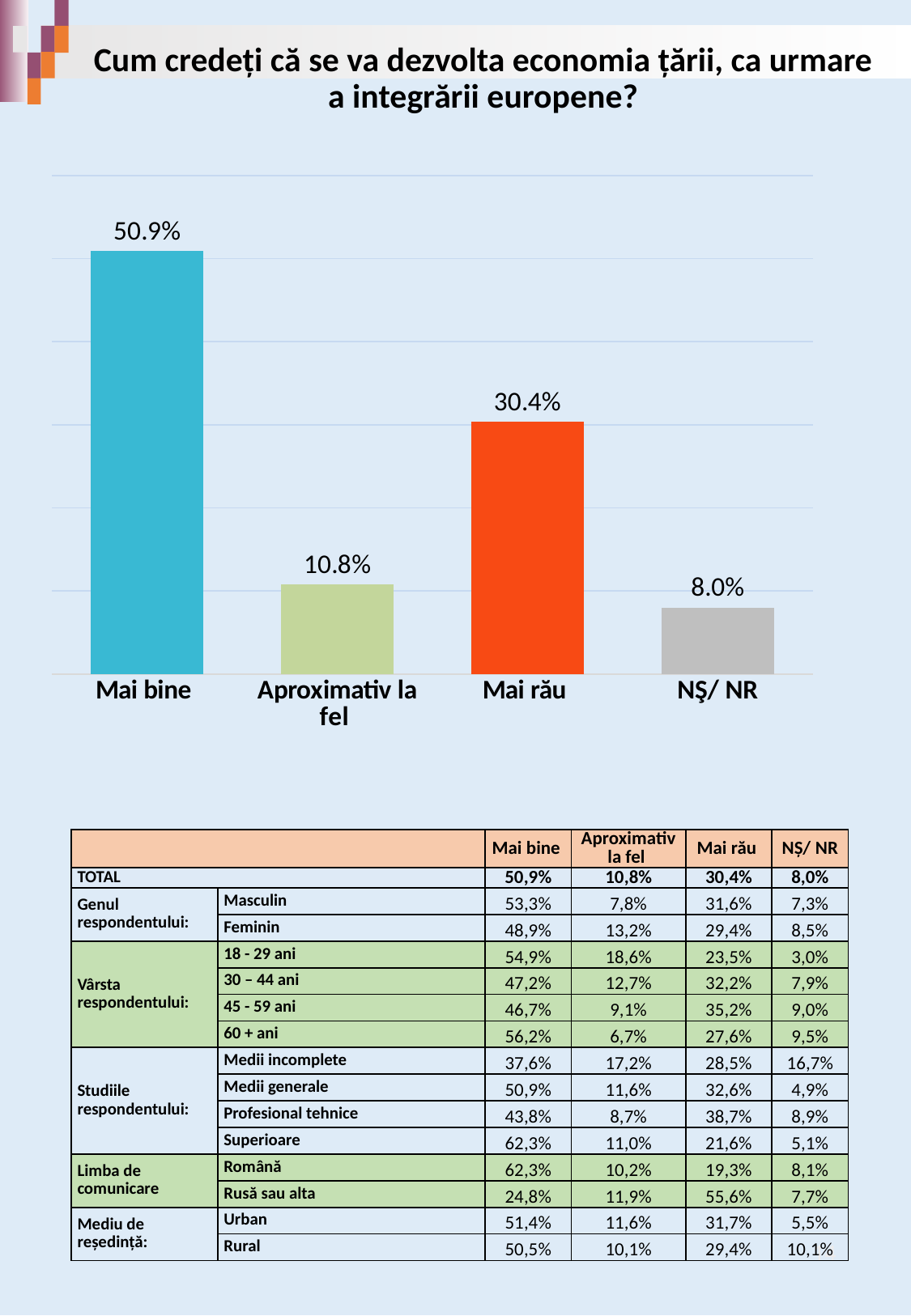
What is the difference between the values for "Mai bine" and "Mai rău" in the bar chart? 20.5% Which is larger in the bar chart, the value for "Mai rău" or the value for "Aproximativ la fel"? Mai rău Which category has the highest value in the bar chart? Mai bine How many categories are shown in the bar chart? 4 What kind of chart is shown on the slide? Bar chart What is the difference between the values for "Aproximativ la fel" and "NȘ/ NR" in the bar chart? 2.8% What is the value shown for "Aproximativ la fel" in the bar chart? 10.8% What is the value shown for "Mai rău" in the bar chart? 30.4% What colour is the bar for "Mai rău" in the bar chart? Orange-red Which category has the lowest value in the bar chart? NȘ/ NR What is the value shown for "Mai bine" in the bar chart? 50.9% What is the value shown for "NȘ/ NR" in the bar chart? 8.0%